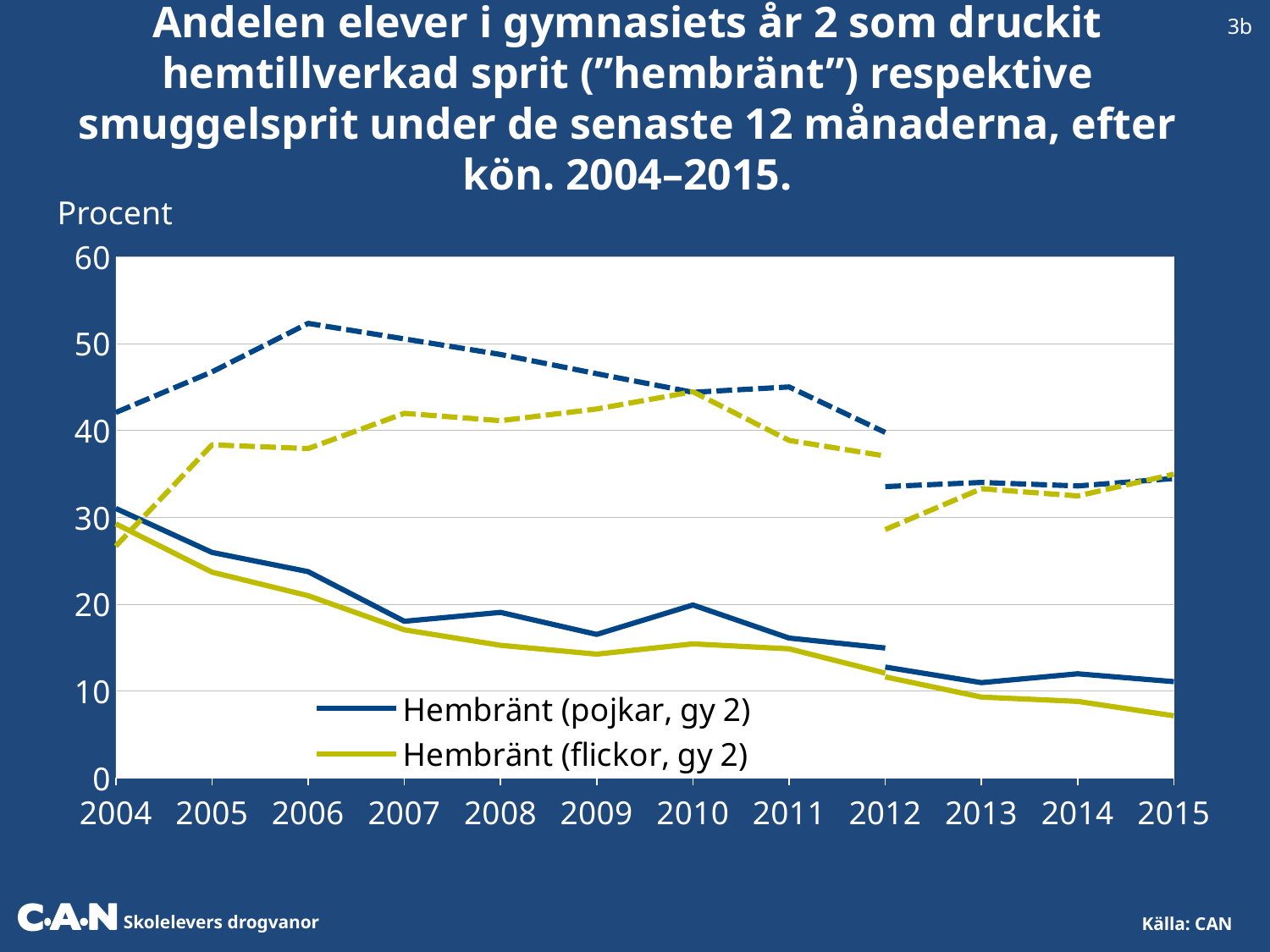
Is the value for Hembränt (pojkar, gy 2) in 2015 greater or less than 20? less How many years are shown along the x axis of the chart? 12 Does the value for Hembränt (flickor, gy 2) rise or fall from 2004 to 2015? fall Is the value for Hembränt (flickor, gy 2) in 2015 greater or less than 10? less Is the value for Hembränt (pojkar, gy 2) in 2010 greater or less than 10? greater Does the value for Hembränt (pojkar, gy 2) rise or fall from 2004 to 2015? fall What label is shown above the y axis of the chart? Procent How many series does the chart's legend list? 2 In 2010, which is higher: Hembränt (pojkar, gy 2) or Hembränt (flickor, gy 2)? Hembränt (pojkar, gy 2) For Hembränt (pojkar, gy 2), which year has the higher value: 2004 or 2015? 2004 What kind of chart is shown on the slide? line chart